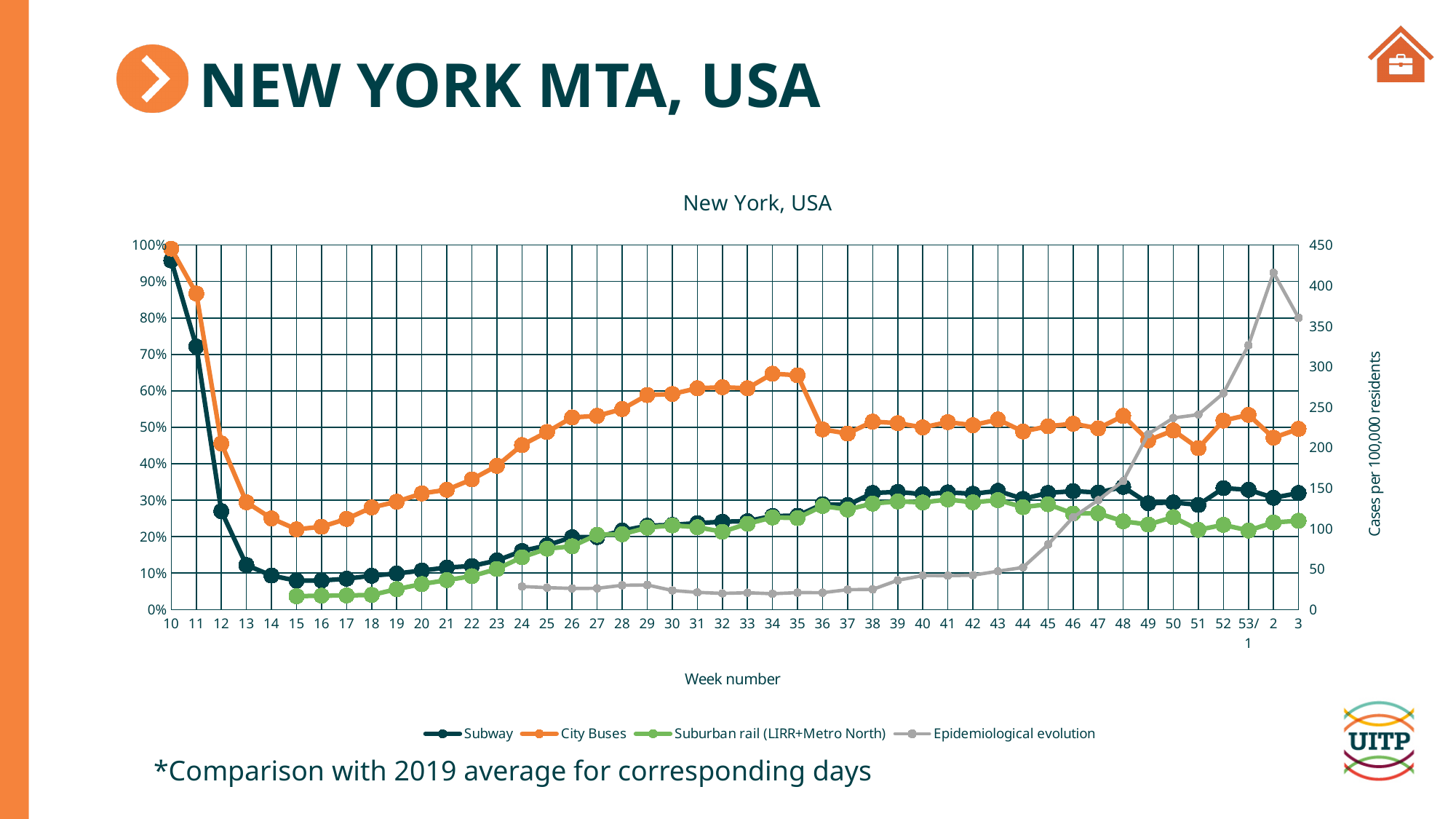
Is the Subway value at week 13 greater or less than 20%? less Is the City Buses value at week 34 greater or less than 60%? greater What kind of chart is shown on the slide? line chart Is the Epidemiological evolution value at week 2 greater or less than 350 on the right axis? greater What is the title of the chart? New York, USA Do the City Buses values rise or fall from week 15 to week 34? rise Which series has the lowest value at week 20? Suburban rail (LIRR+Metro North) How many series does the legend of the chart list? 4 Which series has the highest value at week 40? City Buses What is the label of the right-hand vertical axis? Cases per 100,000 residents Do the Subway values rise or fall from week 10 to week 14? fall At week 30, which is larger: the City Buses value or the Subway value? City Buses